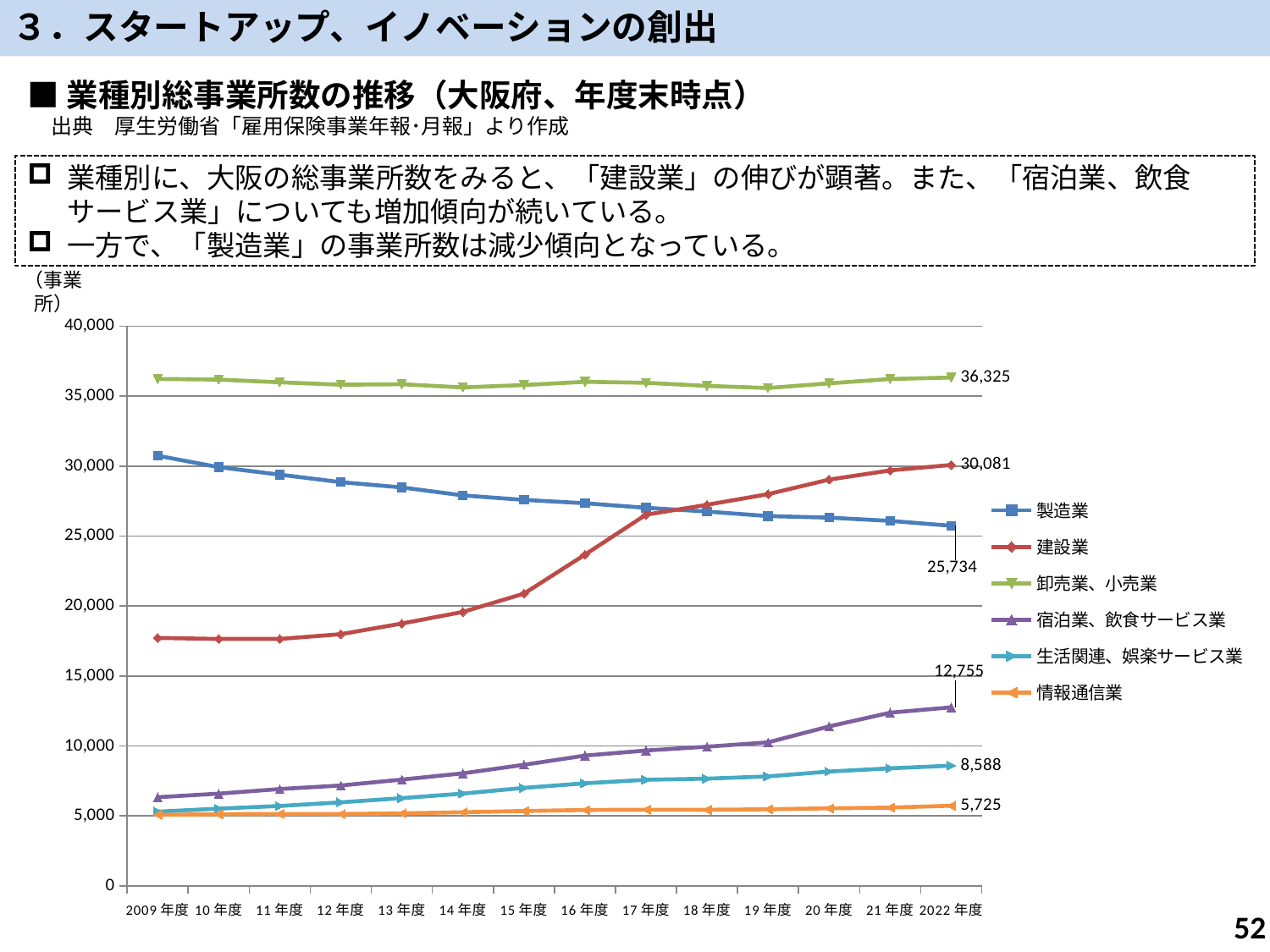
What is the value for 製造業 in 2022年度? 25,734 What is the value for 情報通信業 in 2022年度? 5,725 Which series has the lowest value in 2022年度? 情報通信業 How many series does the legend list? 6 Does the 製造業 series rise or fall from 2009年度 to 2022年度? fall What type of chart is shown on the slide? line chart What is the value for 宿泊業、飲食サービス業 in 2022年度? 12,755 Which series has the highest value in 2022年度? 卸売業、小売業 What is the value for 卸売業、小売業 in 2022年度? 36,325 What is the difference between the 2022年度 values of 建設業 and 製造業? 4,347 How many fiscal years are plotted along the x axis? 14 What is the value for 建設業 in 2022年度? 30,081